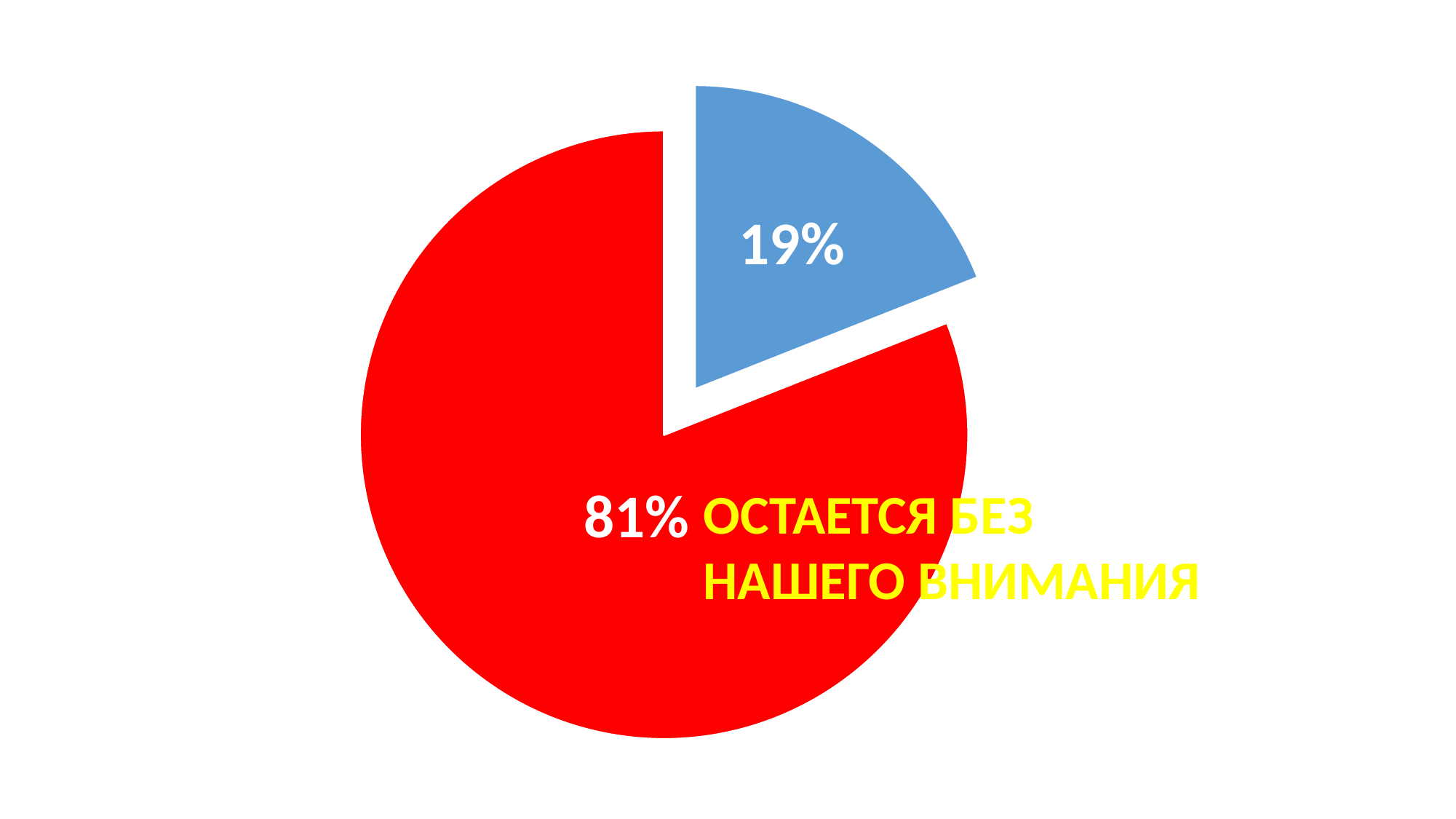
What percentage is labelled on the slice described as "ОСТАЕТСЯ БЕЗ НАШЕГО ВНИМАНИЯ"? 81% What colour is the slice that is pulled out from the rest of the pie? blue How many slices does the pie chart have? 2 What text in yellow accompanies the 81% label on the chart? ОСТАЕТСЯ БЕЗ НАШЕГО ВНИМАНИЯ What share of the pie does the red slice represent? 81% Which slice is the largest in the pie chart? the red slice (81%) What kind of chart is shown on the slide? pie chart What is the difference in percentage points between the red slice and the blue slice? 62 Which slice is the smallest in the pie chart? the blue slice (19%) Is the value of the blue slice greater or less than 25%? less Which slice is larger, the red one or the blue one? the red one What share of the pie does the blue slice represent? 19%